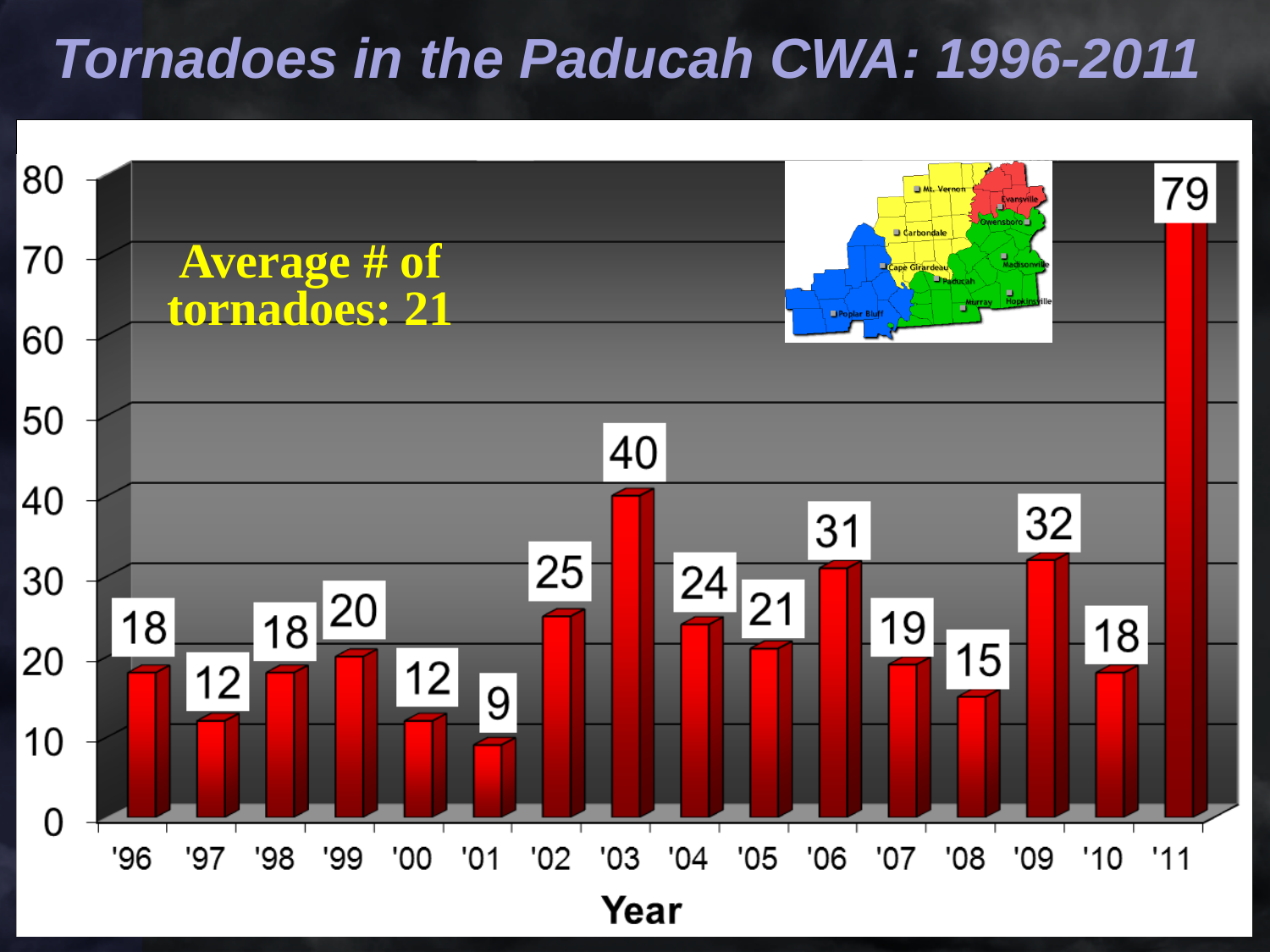
What is the value for '11? 79 What kind of chart is shown on the slide? bar chart Is the value for '02 greater or less than 20? greater Which year has the lowest number of tornadoes? '01 What is the average number of tornadoes stated on the slide? 21 How many tornadoes were recorded in '03? 40 Which year has the highest number of tornadoes? '11 How many tornadoes were recorded in '01? 9 What is the difference between the values for '09 and '10? 14 How many years are shown on the x axis? 16 Which is larger, the value for '06 or the value for '04? '06 What is the difference between the values for '11 and '03? 39